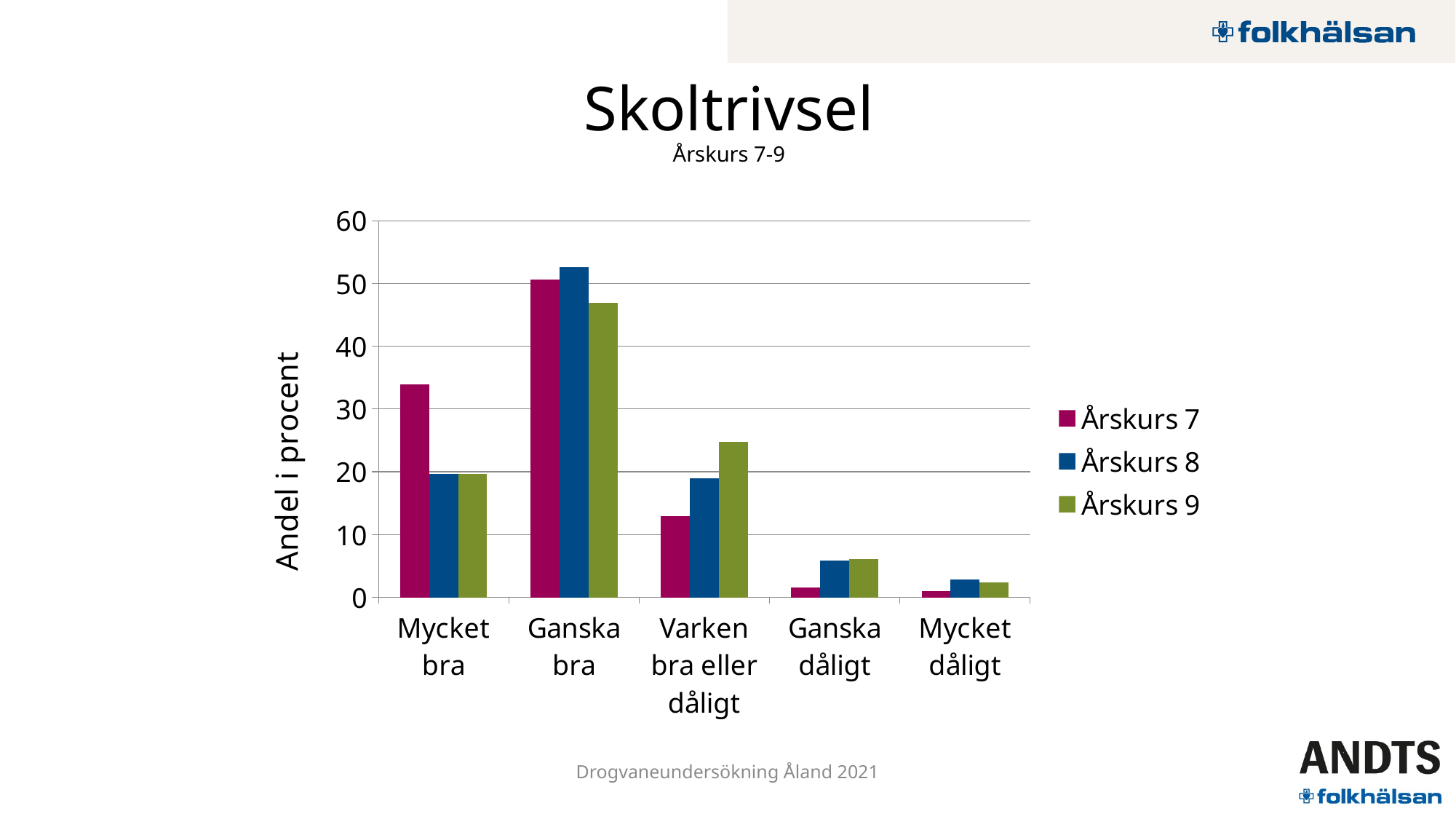
What is the title of the y axis? Andel i procent Is the value for Årskurs 7 in the category Varken bra eller dåligt greater or less than 20? less How many series does the legend list? 3 Is the value for Årskurs 8 in the category Ganska bra greater or less than 50? greater In the category Varken bra eller dåligt, which is larger: the value for Årskurs 7 or for Årskurs 9? Årskurs 9 In the category Mycket bra, which is larger: the value for Årskurs 7 or for Årskurs 8? Årskurs 7 Is the value for Årskurs 9 in the category Varken bra eller dåligt greater or less than 20? greater What kind of chart is shown on the slide? Bar chart Which category has the highest value for Årskurs 9? Ganska bra How many categories are shown on the x axis? 5 Which category has the highest value for Årskurs 7? Ganska bra